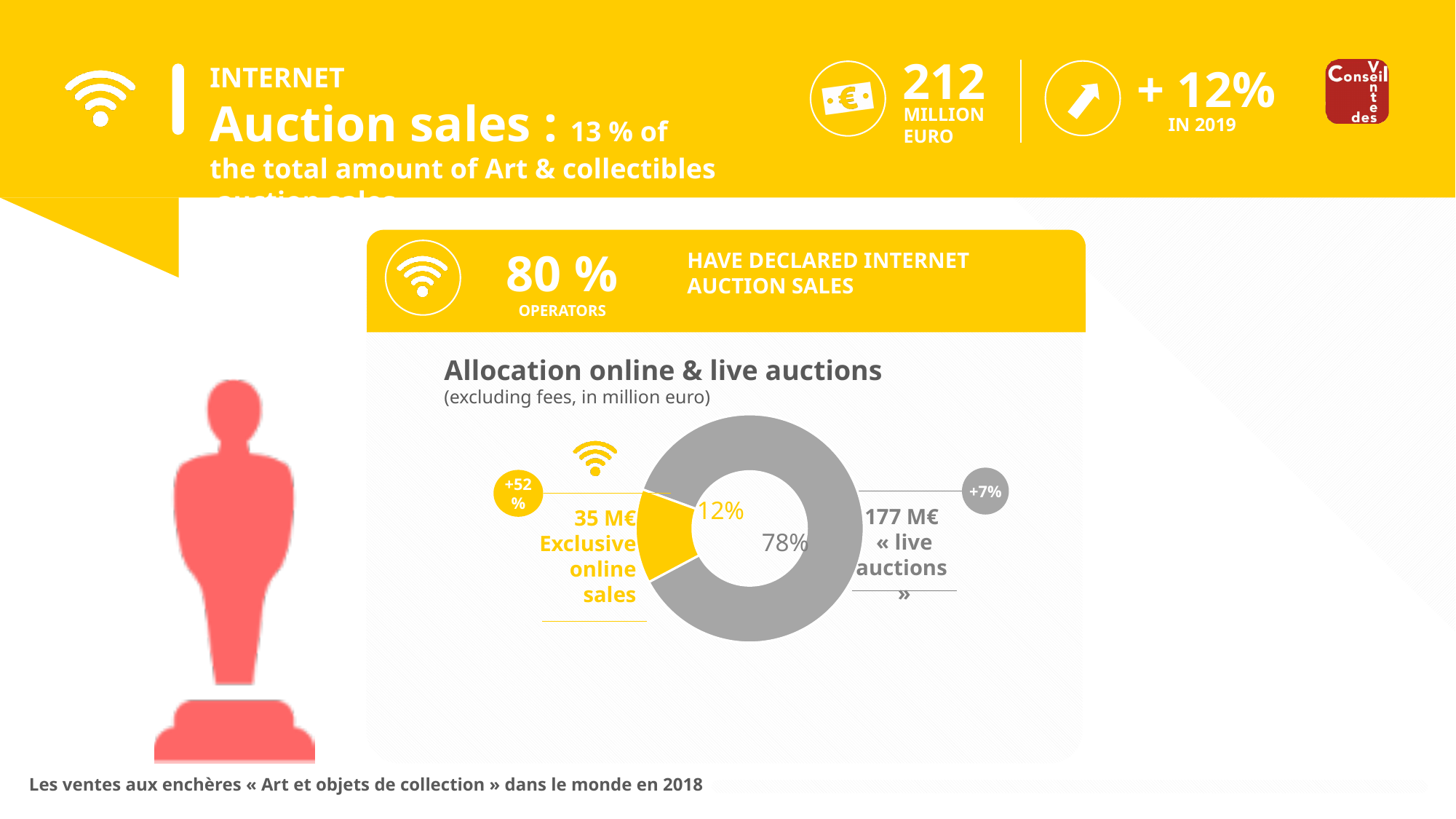
In the "Allocation online & live auctions" chart, what amount in million euro is given for exclusive online sales? 35 M€ In the "Allocation online & live auctions" chart, which slice is the largest? Live auctions In the "Allocation online & live auctions" chart, what percentage is shown for the live auctions slice? 78% In the "Allocation online & live auctions" chart, what is the difference in million euro between live auctions and exclusive online sales? 142 M€ In the "Allocation online & live auctions" chart, what colour is the live auctions slice? Grey In the "Allocation online & live auctions" chart, how many slices does the donut have? 2 In the "Allocation online & live auctions" chart, which slice is the smallest? Exclusive online sales In the "Allocation online & live auctions" chart, what percentage is shown for the exclusive online sales slice? 12% What kind of chart is shown under the title "Allocation online & live auctions"? Pie chart (donut) In the "Allocation online & live auctions" chart, which is larger: exclusive online sales or live auctions? Live auctions In the "Allocation online & live auctions" chart, what growth percentage is shown next to the exclusive online sales slice? +52 % In the "Allocation online & live auctions" chart, what amount in million euro is given for live auctions? 177 M€